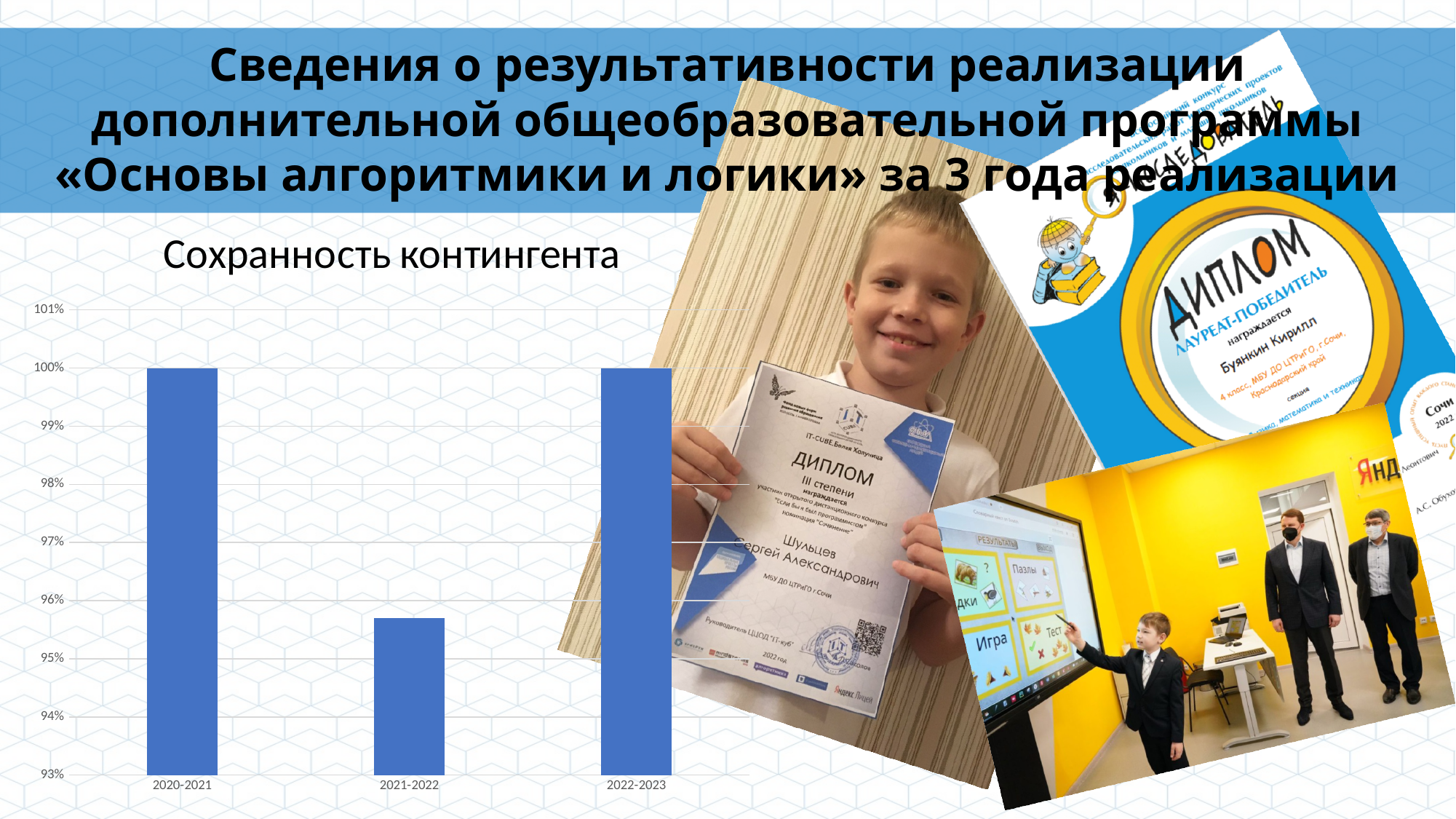
What is the value for 2020-2021 in the chart? 100% Does the value rise or fall from 2021-2022 to 2022-2023? rise Which is larger, the value for 2020-2021 or the value for 2021-2022? 2020-2021 What is the value for 2022-2023 in the chart? 100% What kind of chart is shown under the heading «Сохранность контингента»? bar chart How many categories (academic years) are shown on the x axis of the chart? 3 Is the value for 2021-2022 greater or less than 96%? less Is the value for 2021-2022 greater or less than 95%? greater Which academic year has the lowest value in the chart? 2021-2022 What is the title of the chart on the slide? Сохранность контингента What is the highest percentage shown on the y axis of the chart? 101%